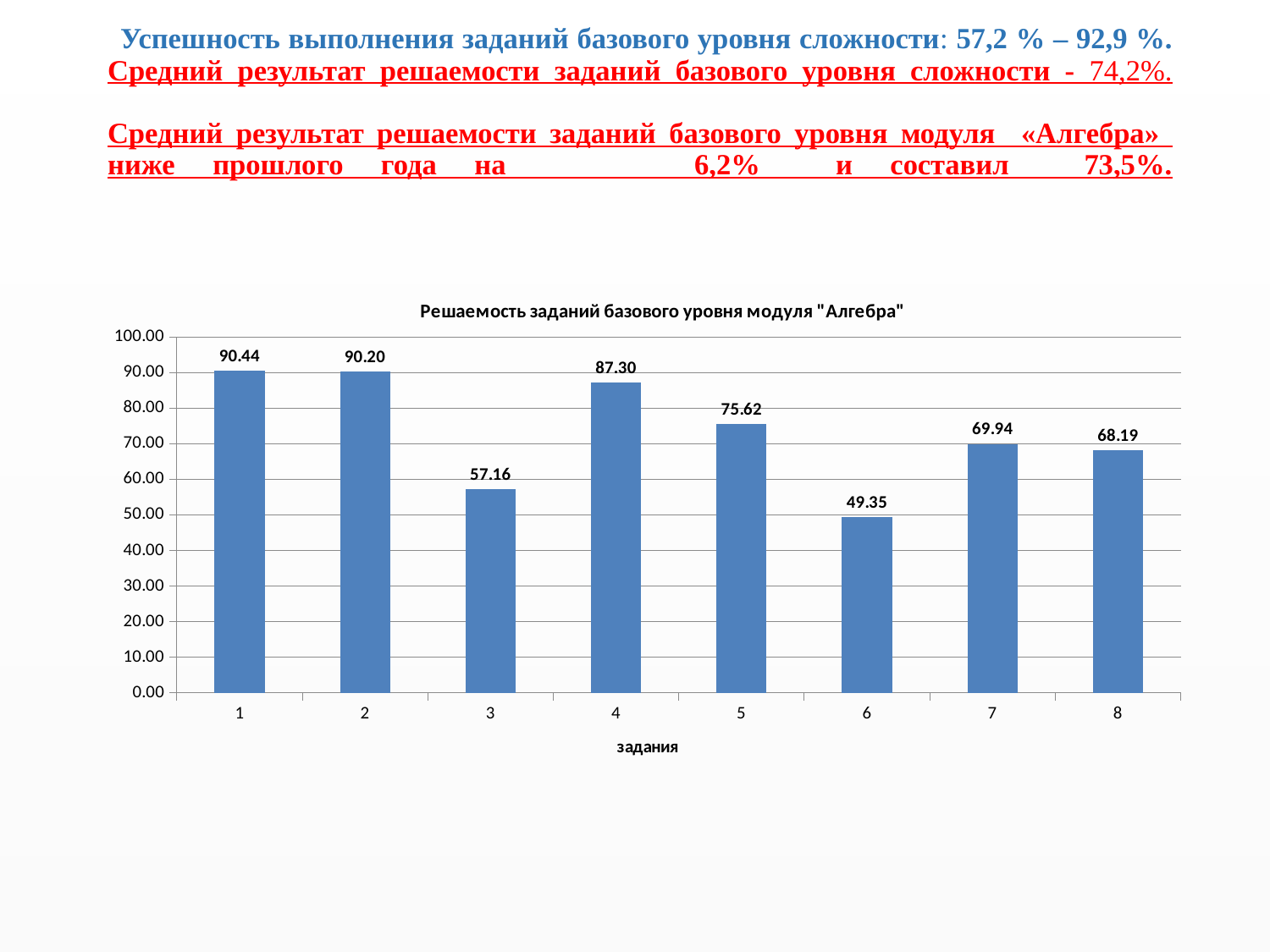
What is the value for task 6? 49.35 Is the value for task 3 greater or less than 60.00? less Which task has the lowest value? 6 How many tasks are shown on the x axis? 8 What is the value for task 4? 87.30 What is the difference between the values for task 1 and task 6? 41.09 What is the value for task 1? 90.44 What is the title of the chart? Решаемость заданий базового уровня модуля "Алгебра" What kind of chart is shown? bar chart Which is larger, the value for task 7 or task 8? 7 Which task has the highest value? 1 What is the label of the x axis? задания